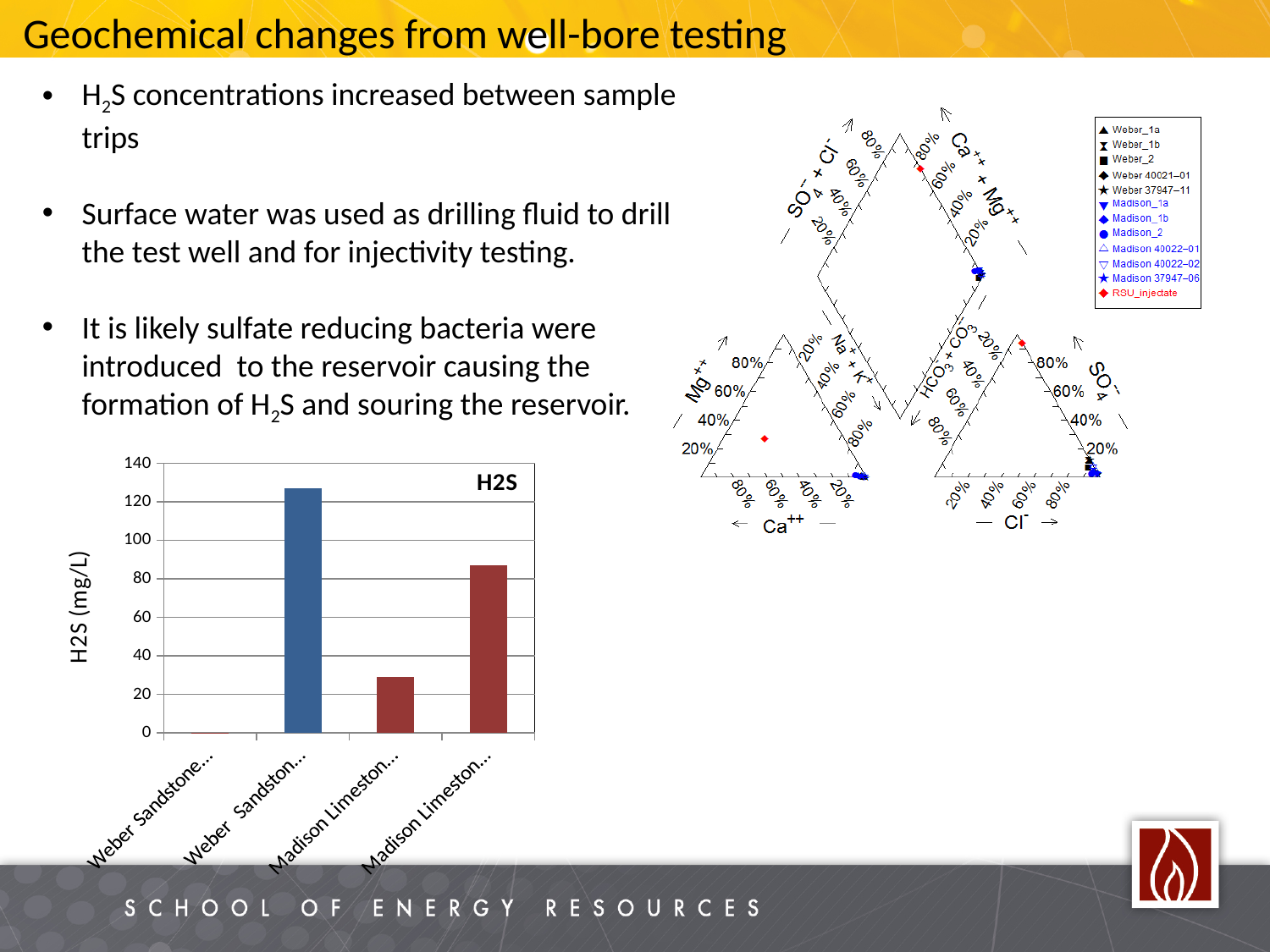
In the H2S bar chart, which bar is the tallest? the second bar (Weber Sandston...) In the H2S bar chart, is the value of the second bar greater or less than 120? greater What is the y-axis label of the H2S bar chart? H2S (mg/L) In the H2S bar chart, is the value of the fourth bar greater or less than 100? less How many bars (categories) are plotted in the H2S bar chart? 4 In the H2S bar chart, which bar is the lowest? the first bar (Weber Sandstone...) In the H2S bar chart, is the value of the fourth bar greater or less than 80? greater What kind of chart is the H2S chart on the slide? bar chart In the H2S bar chart, which is larger: the third bar or the fourth bar? the fourth bar What is the maximum value shown on the y-axis of the H2S bar chart? 140 In the H2S bar chart, which is larger: the second bar or the fourth bar? the second bar